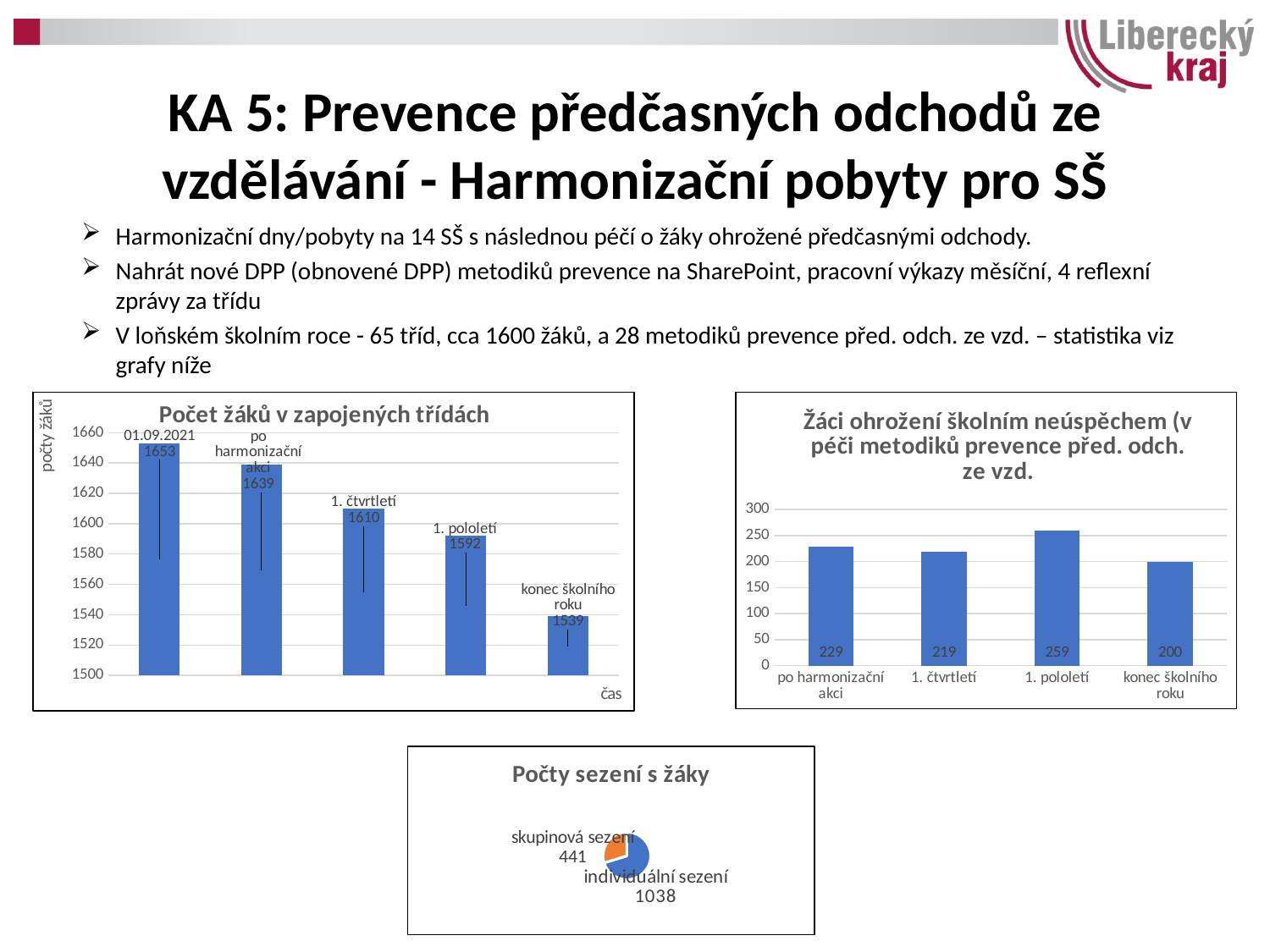
How many bars are in the chart 'Počet žáků v zapojených třídách'? 5 In the chart 'Počet žáků v zapojených třídách', what is the difference between the values for 01.09.2021 and konec školního roku? 114 In the chart 'Počty sezení s žáky', what is the value for individuální sezení? 1038 In the chart 'Žáci ohrožení školním neúspěchem', which is larger: po harmonizační akci or 1. čtvrtletí? po harmonizační akci In the chart 'Žáci ohrožení školním neúspěchem', which category has the highest value? 1. pololetí In the chart 'Počet žáků v zapojených třídách', do the values rise or fall along the x axis? fall What kind of chart is 'Počty sezení s žáky'? pie chart In the chart 'Počet žáků v zapojených třídách', which category has the lowest value? konec školního roku In the chart 'Počet žáků v zapojených třídách', what is the value for 01.09.2021? 1653 In the chart 'Žáci ohrožení školním neúspěchem', what is the value for 1. pololetí? 259 In the chart 'Žáci ohrožení školním neúspěchem', what is the difference between 1. pololetí and konec školního roku? 59 In the chart 'Počet žáků v zapojených třídách', what is the value for konec školního roku? 1539